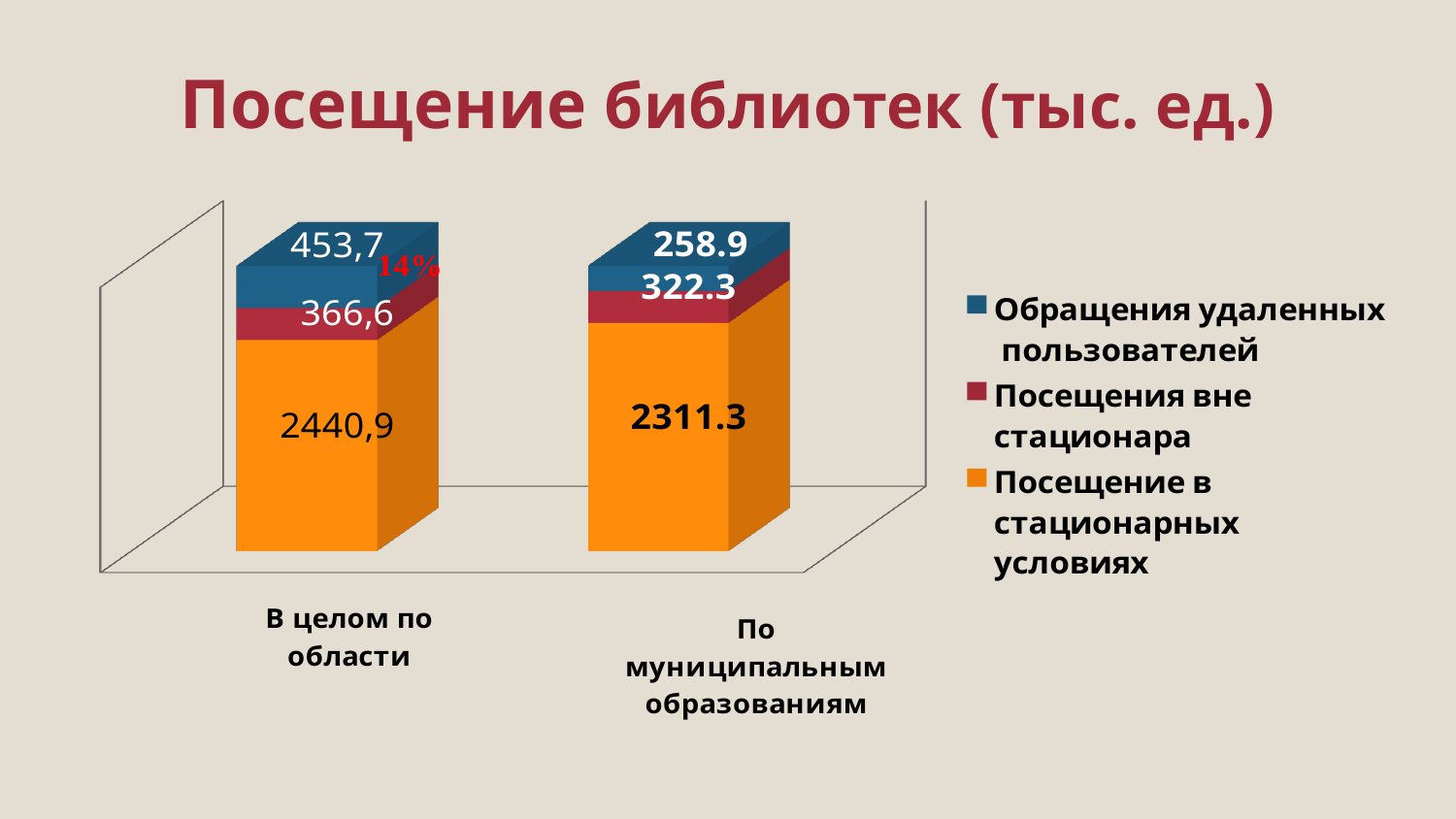
What kind of chart is shown on the slide? Stacked bar chart What is the value for Посещение в стационарных условиях for В целом по области? 2440,9 What is the value for Обращения удаленных пользователей for По муниципальным образованиям? 258.9 Which series has the largest value in the В целом по области bar? Посещение в стационарных условиях How many series does the legend list? 3 Which series has the smallest value in the По муниципальным образованиям bar? Обращения удаленных пользователей Which is larger: Обращения удаленных пользователей for В целом по области or for По муниципальным образованиям? В целом по области What is the difference between Посещение в стационарных условиях for В целом по области and for По муниципальным образованиям? 129,6 What is the total of the stacked bar for По муниципальным образованиям? 2892.5 What is the value for Обращения удаленных пользователей for В целом по области? 453,7 What is the value for Посещения вне стационара for В целом по области? 366,6 What is the value for Посещения вне стационара for По муниципальным образованиям? 322.3